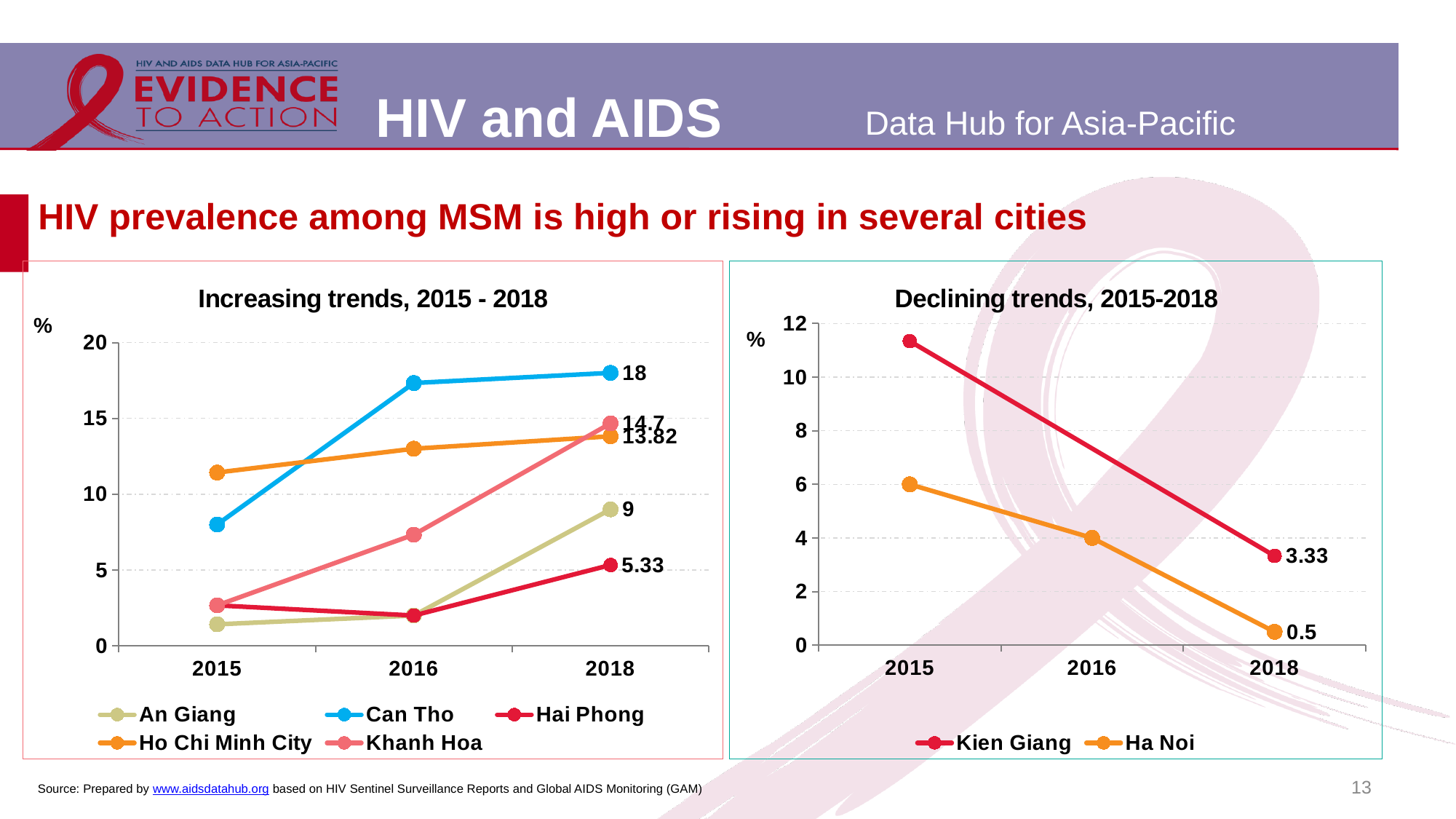
In the 'Increasing trends, 2015 - 2018' chart, which is larger in 2018: Khanh Hoa or Ho Chi Minh City? Khanh Hoa In the 'Increasing trends, 2015 - 2018' chart, is the value for Ho Chi Minh City in 2015 greater or less than 10? greater In the 'Increasing trends, 2015 - 2018' chart, what is the value for Hai Phong in 2018? 5.33 In the 'Increasing trends, 2015 - 2018' chart, which city has the highest value in 2018? Can Tho In the 'Increasing trends, 2015 - 2018' chart, what is the difference between the 2018 values for Can Tho and An Giang? 9 In the 'Declining trends, 2015-2018' chart, what is the difference between the 2018 values for Kien Giang and Ha Noi? 2.83 What kind of chart is the 'Declining trends, 2015-2018' chart? line chart In the 'Increasing trends, 2015 - 2018' chart, what is the value for Can Tho in 2018? 18 In the 'Declining trends, 2015-2018' chart, what is the value for Kien Giang in 2018? 3.33 In the 'Increasing trends, 2015 - 2018' chart, which city has the lowest value in 2018? Hai Phong How many series does the legend of the 'Increasing trends, 2015 - 2018' chart list? 5 In the 'Increasing trends, 2015 - 2018' chart, what is the value for Khanh Hoa in 2018? 14.7